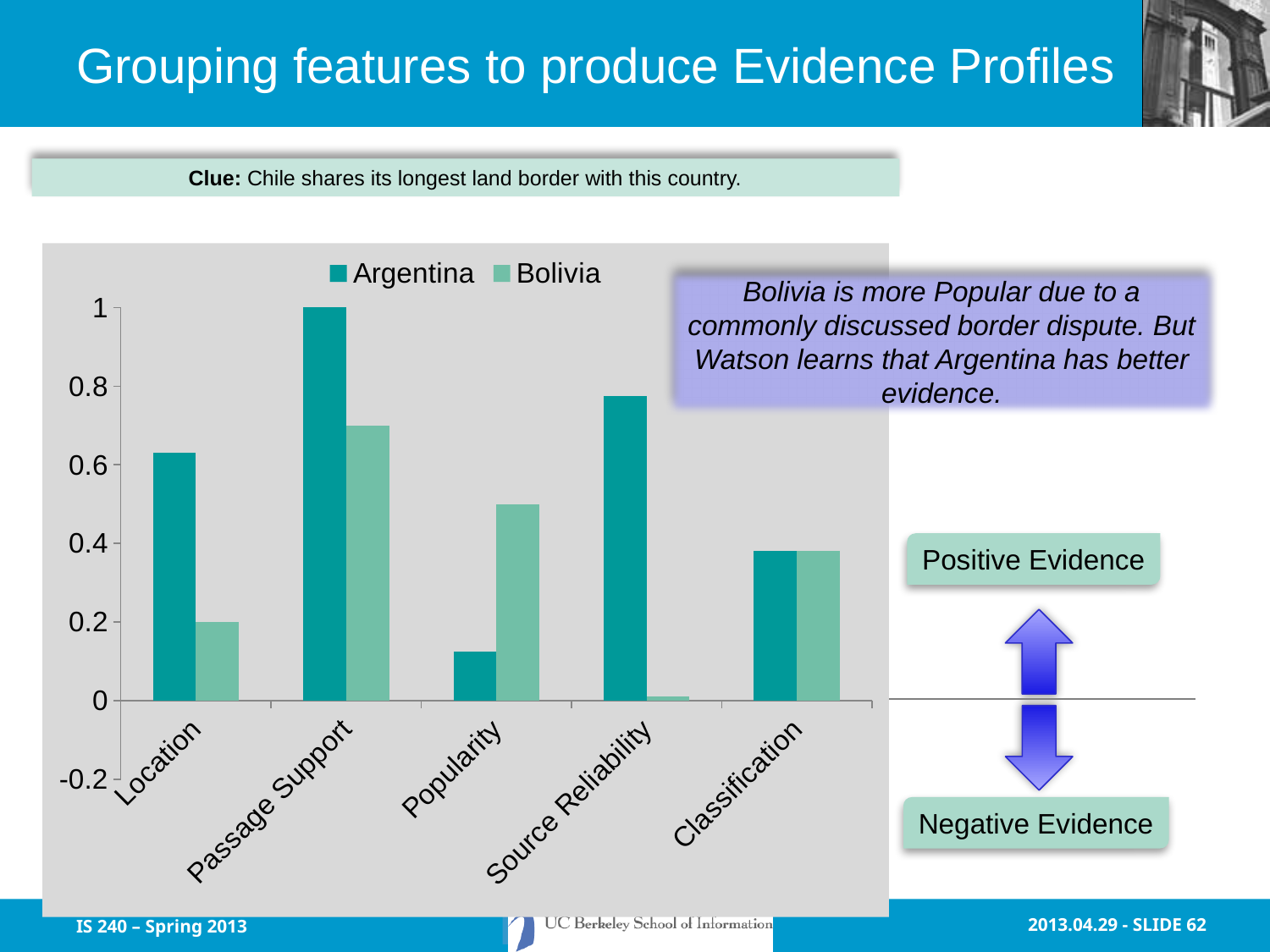
In the Location category, which series has the larger value, Argentina or Bolivia? Argentina What is the value for Argentina in the Passage Support category? 1 How many categories are shown on the x axis of the chart? 5 Is the value for Argentina in the Source Reliability category greater or less than 0.6? greater For which category is the Bolivia value highest? Passage Support For which category is the Argentina value highest? Passage Support In the Popularity category, which series has the larger value, Argentina or Bolivia? Bolivia For which category is the Argentina value lowest? Popularity Is the value for Bolivia in the Source Reliability category greater or less than 0.2? less For which category is the Bolivia value lowest? Source Reliability How many series does the chart's legend list? 2 What type of chart is shown on the slide? bar chart